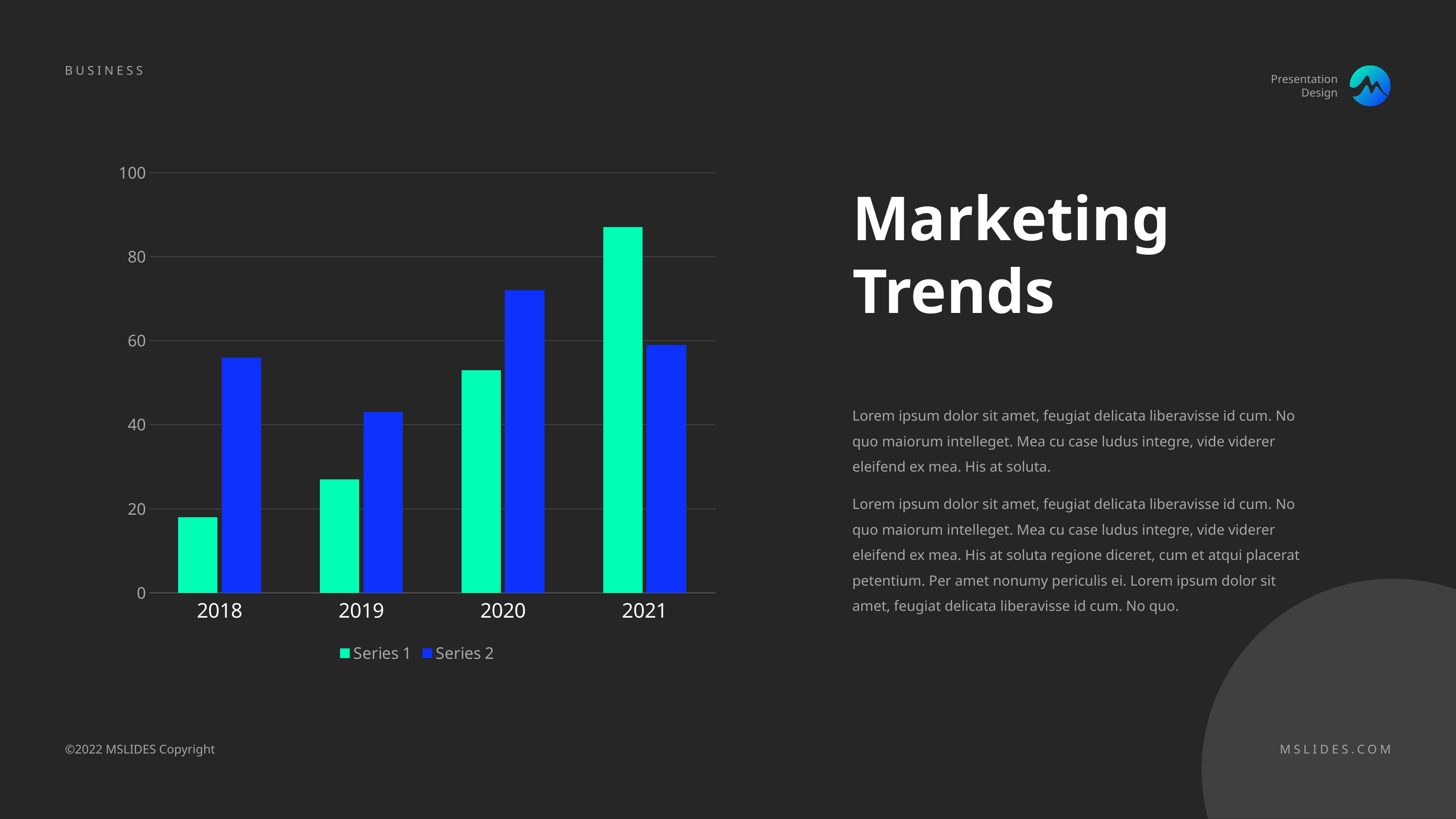
What are the two entries listed in the chart's legend? Series 1 and Series 2 Which year has the highest value for Series 2? 2020 In 2021, which series has the larger value, Series 1 or Series 2? Series 1 How many series does the chart's legend list? 2 Do the Series 1 values rise or fall from 2018 to 2021? rise Which year has the lowest value for Series 1? 2018 Which year has the lowest value for Series 2? 2019 How many categories are shown on the x axis of the chart? 4 What kind of chart is shown on the slide? bar chart In 2018, which series has the larger value, Series 1 or Series 2? Series 2 Is the value for Series 1 in 2021 greater or less than 80? greater Which year has the highest value for Series 1? 2021